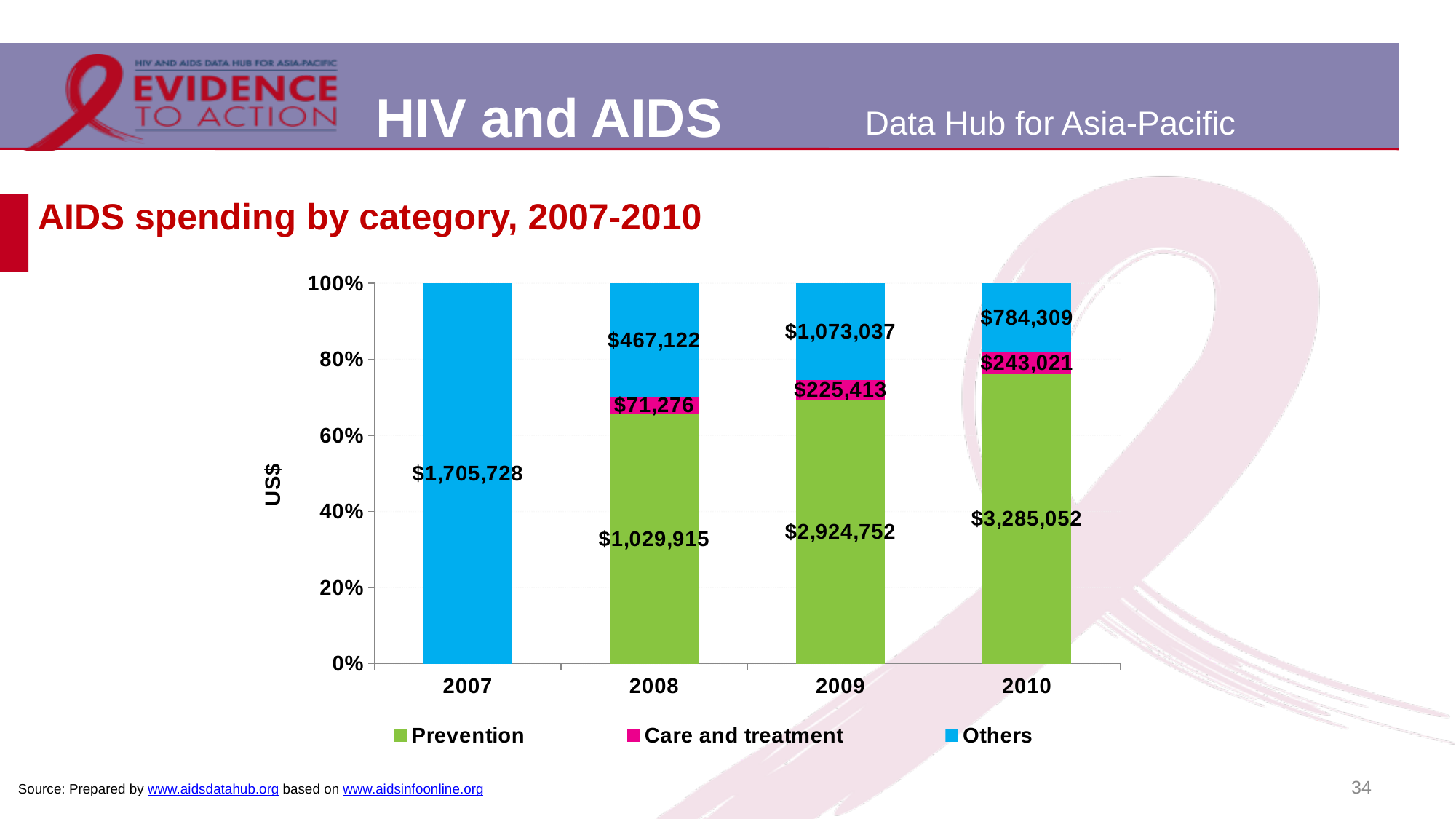
What is the value for Others in 2010? $784,309 How many years are shown on the x axis? 4 What is the total spending across all three categories in 2008? $1,568,313 What is the value for Prevention in 2009? $2,924,752 What is the value for Others in 2007? $1,705,728 In which year is the Prevention value highest? 2010 What is the difference between the Prevention values for 2010 and 2009? $360,300 What kind of chart is shown on the slide? Stacked bar chart What is the value for Care and treatment in 2008? $71,276 Which is larger, the Others value in 2009 or the Others value in 2010? 2009 How many series does the legend list? 3